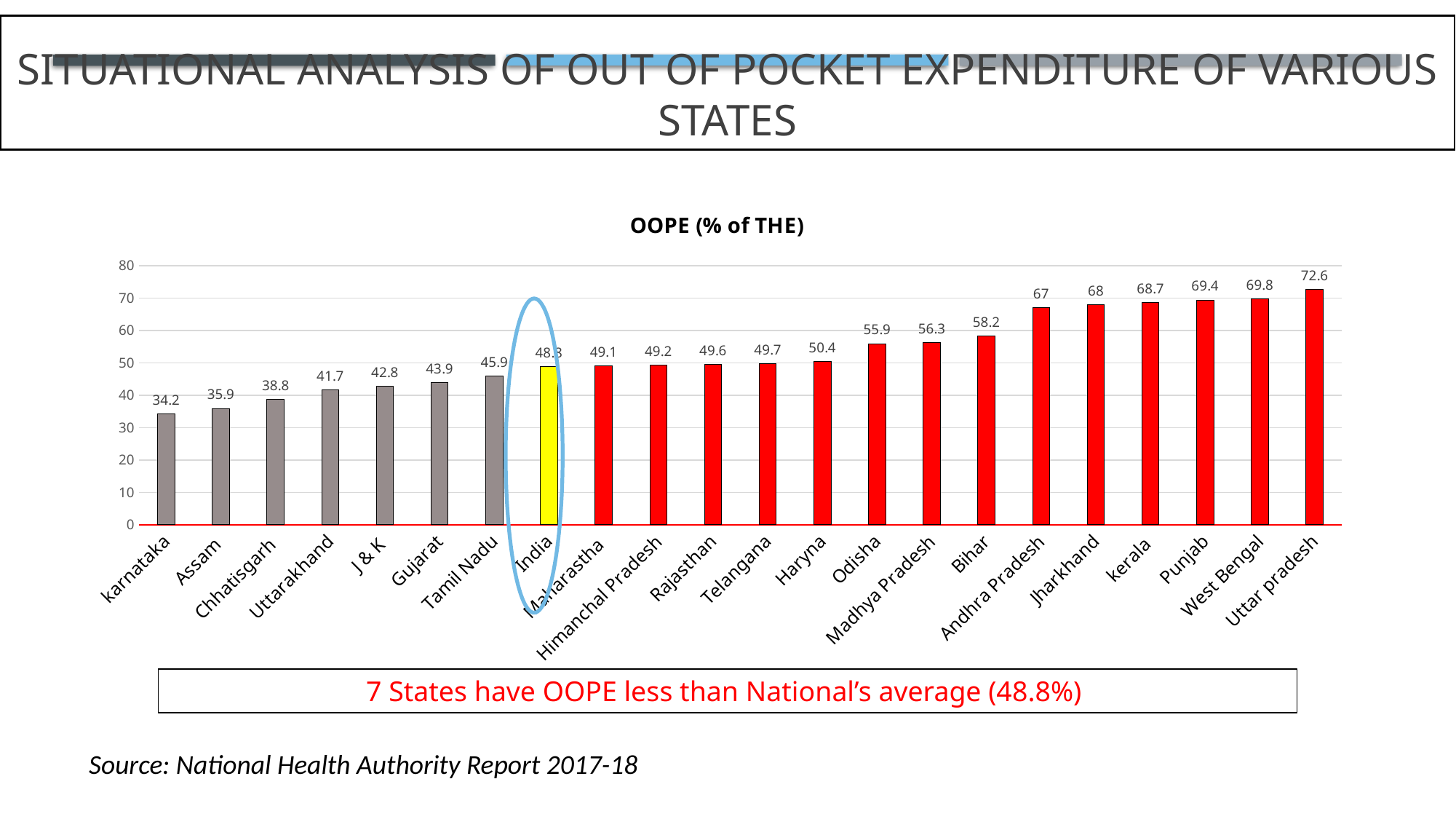
What is the OOPE (% of THE) value for Gujarat? 43.9 What is the OOPE (% of THE) value for Bihar? 58.2 Which state has the highest OOPE (% of THE)? Uttar pradesh Do the OOPE values rise or fall moving from left to right along the x axis? rise What is the difference between the OOPE values of Uttar pradesh and karnataka? 38.4 What is the difference between the OOPE values of Andhra Pradesh and Odisha? 11.1 How many bars are plotted in the OOPE (% of THE) chart? 22 Which state has the lowest OOPE (% of THE)? karnataka What is the OOPE (% of THE) value for Uttar pradesh? 72.6 What type of chart is shown on the slide? bar chart Which has a higher OOPE (% of THE), Punjab or Tamil Nadu? Punjab Is the OOPE value for Madhya Pradesh greater or less than 50? greater